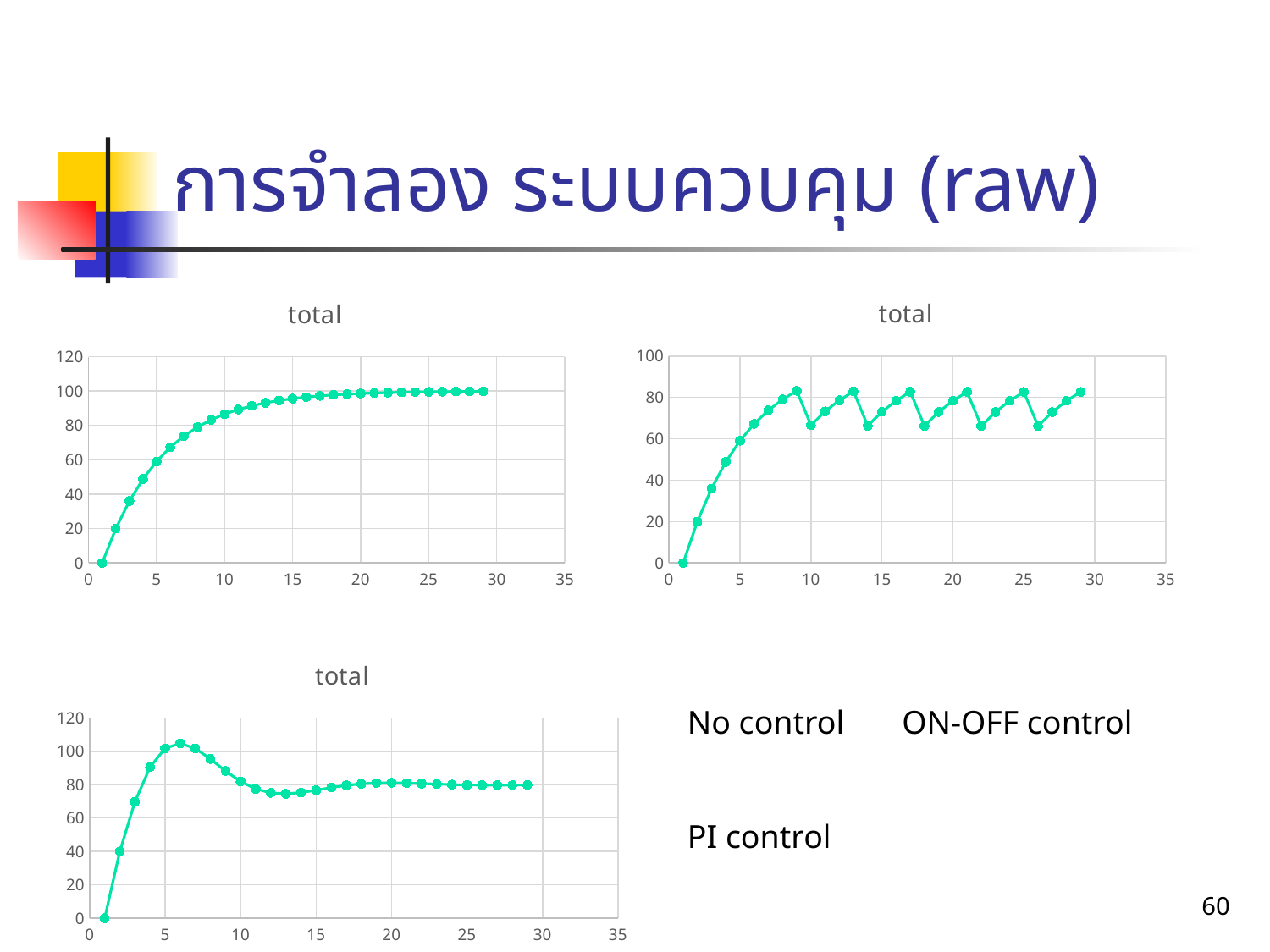
In the top-left chart, do the values rise or fall as x increases from 1 to 10? rise In the top-left chart, which is larger: the value at x = 5 or the value at x = 10? x = 10 In the top-right chart, is the value at x = 5 greater or less than 40? greater In the top-left chart, is the value at x = 20 greater or less than 80? greater In the bottom-left chart, at which x value does the line reach its highest point? 6 In the bottom-left chart, is the value at x = 6 greater or less than 100? greater What is the title shown above each of the three charts? total How many charts are shown on the slide? 3 What kind of chart is the top-left chart? line chart In the top-left chart, what is the value at x = 1? 0